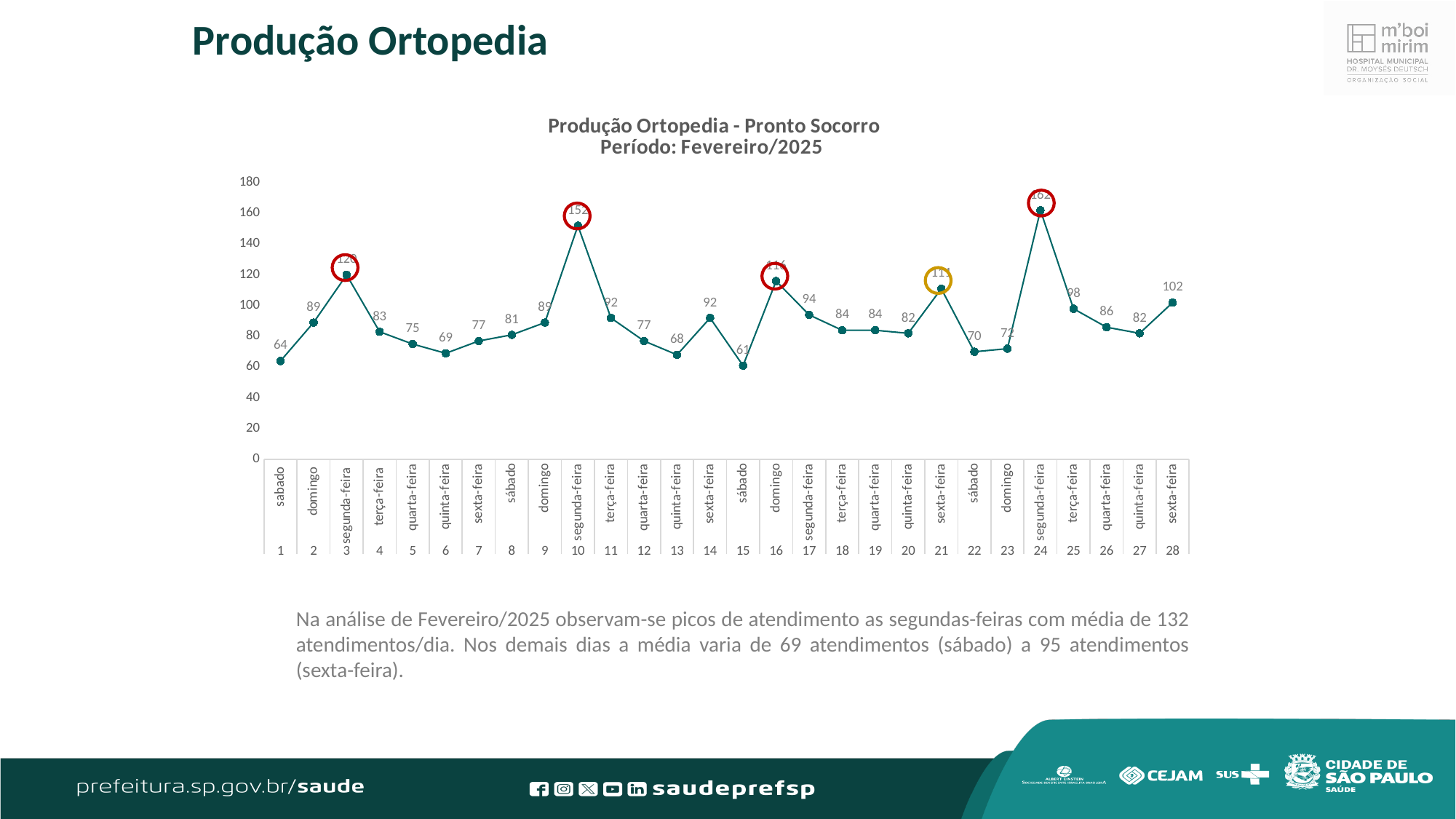
How many days are plotted in the chart? 28 Which day has the lowest value in the chart? Day 15 (sábado), 61 Do the values rise or fall from day 24 to day 27? Fall What is the value for day 1 (sábado) in the chart? 64 Which day has the highest value in the chart? Day 24 (segunda-feira), 162 What kind of chart is shown on the slide? Line chart What is the value for day 28 (sexta-feira) in the chart? 102 Which is larger, the value for day 2 (domingo) or day 4 (terça-feira)? Day 2 (domingo) What is the value for day 10 (segunda-feira) in the chart? 152 Is the value for day 3 (segunda-feira) greater or less than 100? greater What is the difference between the values for day 2 and day 1? 25 What is the difference between the values for day 24 and day 10? 10